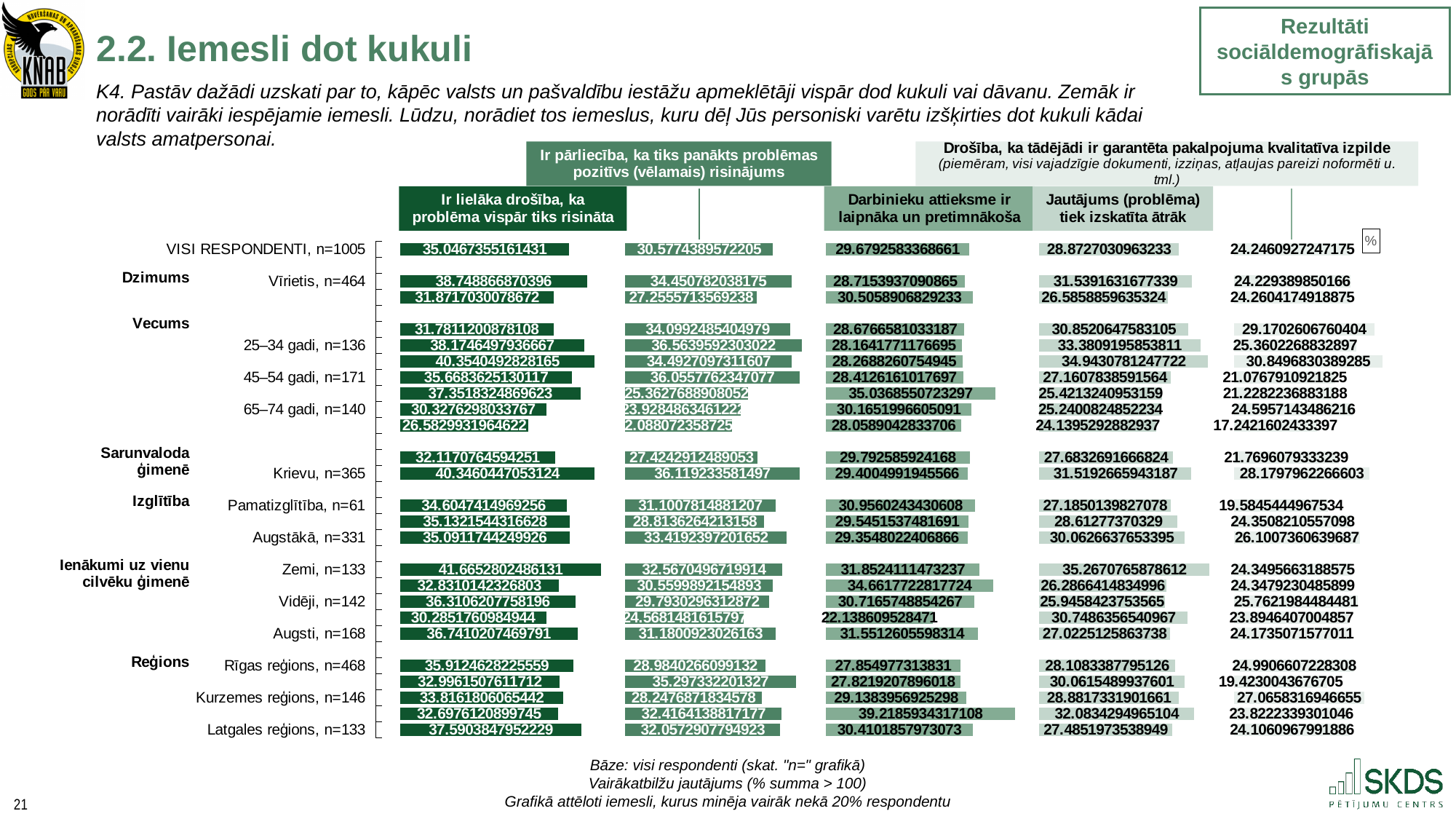
What is the value for Zemi, n=133 in the series "Jautājums (problēma) tiek izskatīta ātrāk"? 35.2670765878612 What is the value for Pamatizglītība, n=61 in the series "Drošība, ka tādējādi ir garantēta pakalpojuma kvalitatīva izpilde"? 19.5845444967534 What is the value for Krievu, n=365 in the series "Ir pārliecība, ka tiks panākts problēmas pozitīvs (vēlamais) risinājums"? 36.119233581497 What is the value for Rīgas reģions, n=468 in the series "Ir lielāka drošība, ka problēma vispār tiks risināta"? 35.9124628225559 What is the value for Latgales reģions, n=133 in the series "Darbinieku attieksme ir laipnāka un pretimnākoša"? 30.4101857973073 Which labeled group has the highest value in the series "Ir lielāka drošība, ka problēma vispār tiks risināta"? Zemi, n=133 Which is larger in the series "Jautājums (problēma) tiek izskatīta ātrāk": the value for 25–34 gadi, n=136 or for 65–74 gadi, n=140? 25–34 gadi, n=136 In the series "Ir lielāka drošība, ka problēma vispār tiks risināta", how much higher is the value for Vīrietis, n=464 than for VISI RESPONDENTI, n=1005? 3.7021313542529 What is the value for VISI RESPONDENTI, n=1005 in the series "Ir lielāka drošība, ka problēma vispār tiks risināta"? 35.0467355161431 Which is larger for Vīrietis, n=464: the value for "Ir lielāka drošība, ka problēma vispār tiks risināta" or for "Ir pārliecība, ka tiks panākts problēmas pozitīvs (vēlamais) risinājums"? Ir lielāka drošība, ka problēma vispār tiks risināta How many reasons (series) are shown as columns in the chart? 5 What kind of chart is shown on the slide? bar chart